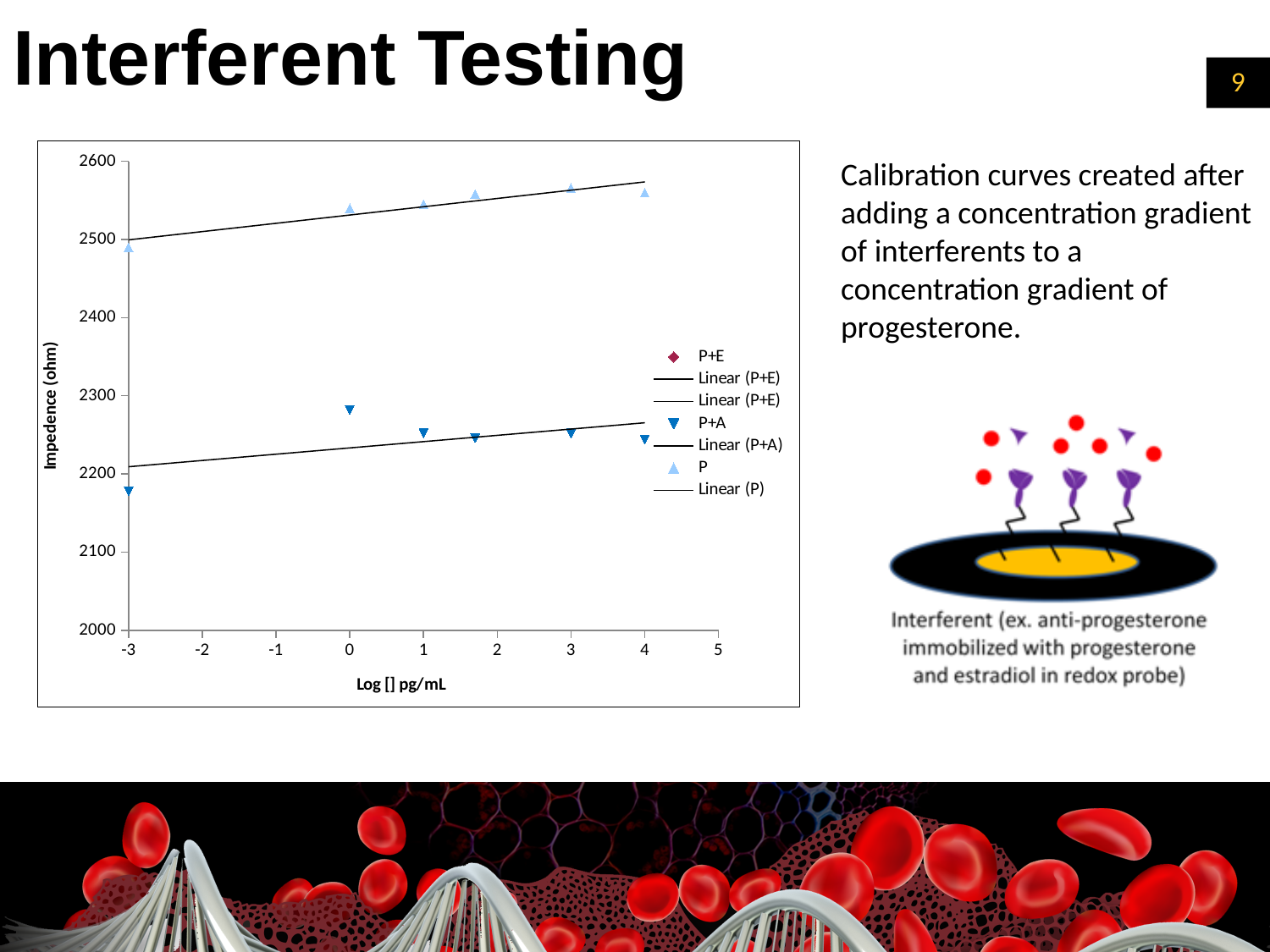
Is the value of the P series at Log [] = 0 greater or less than 2500? greater Which series has the highest impedance values overall, P or P+A? P How many entries does the chart legend list? 7 What kind of chart is shown on the slide? scatter chart Is the value of the P+A series at Log [] = 0 greater or less than 2300? less What is the title of the y axis of the chart? Impedence (ohm) What is the title of the x axis of the chart? Log [] pg/mL At which Log [] value does the P+A series reach its lowest point? -3 Is the value of the P+A series at Log [] = -3 greater or less than 2200? less At Log [] = 3, which series has the higher impedance, P or P+A? P Does the Linear (P) trendline rise or fall as Log [] increases? rise